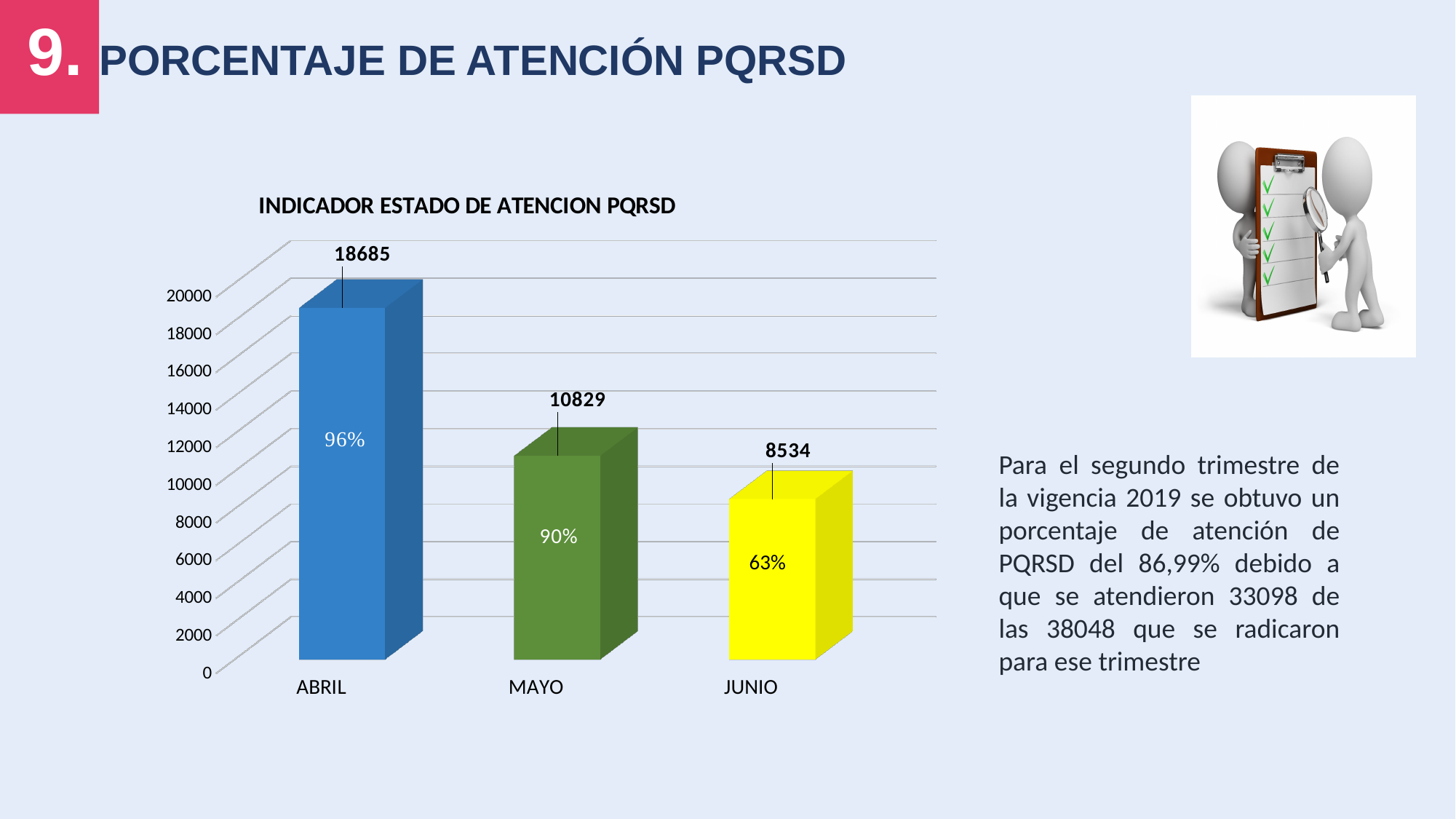
Which month has the lowest value? JUNIO Which month has the highest value? ABRIL How many months are shown on the x axis? 3 What percentage is printed inside the ABRIL bar? 96% What is the value shown for ABRIL? 18685 What is the value shown for MAYO? 10829 What is the difference between the values for ABRIL and MAYO? 7856 What kind of chart is shown on the slide? Bar chart What is the value shown for JUNIO? 8534 Do the values rise or fall from ABRIL to JUNIO? Fall Which is larger, the value for MAYO or the value for JUNIO? MAYO What percentage is printed inside the JUNIO bar? 63%